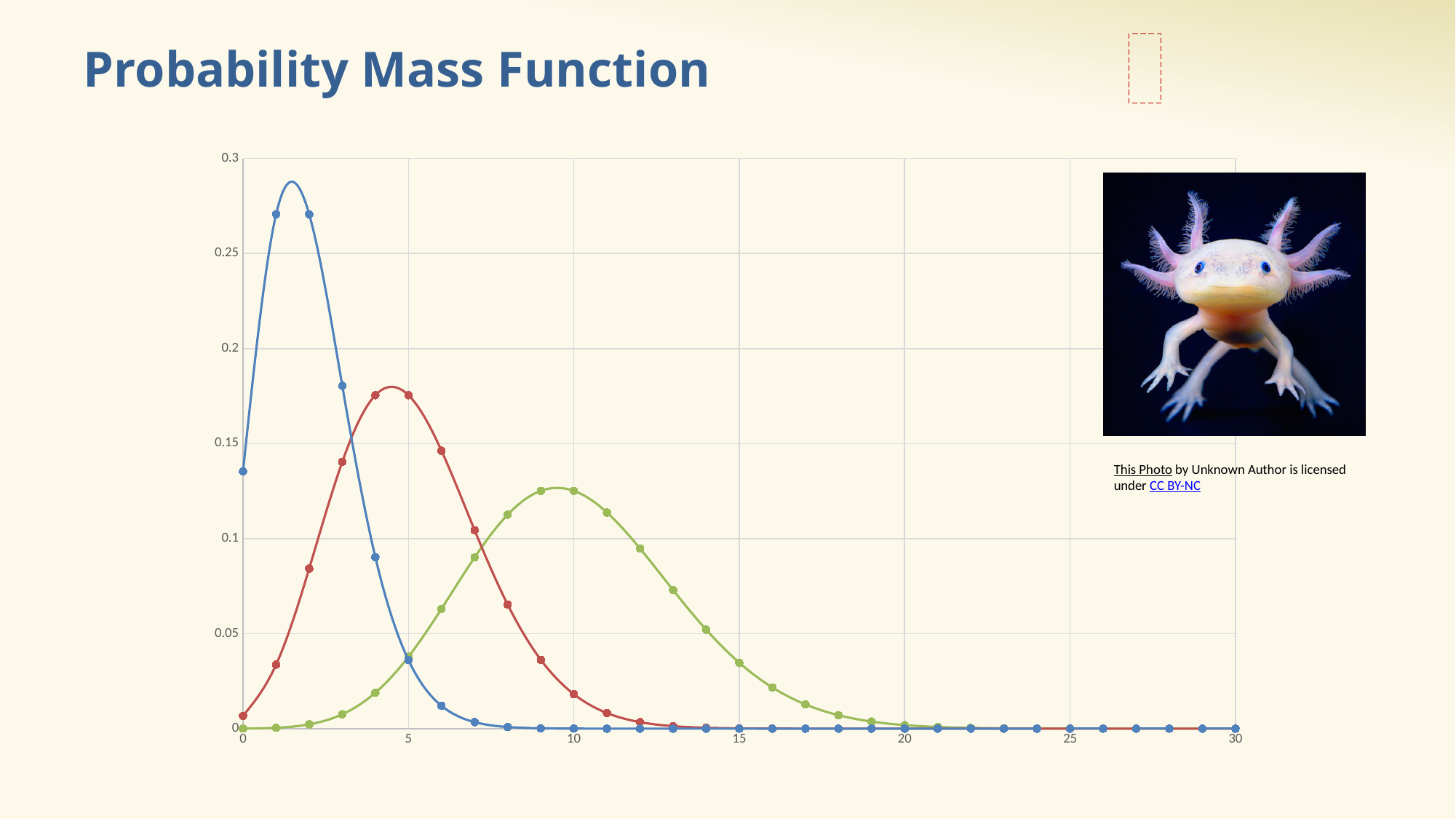
What kind of chart is shown on the slide? line chart Is the value of the blue line at x = 0 greater or less than 0.15? less Do the values of the blue line rise or fall as x increases from 3 to 10? fall Which coloured line reaches the highest peak value? blue At x = 5, which line has the larger value, the red line or the blue line? red How many lines (series) are plotted on the chart? 3 What is the highest value shown on the x axis? 30 Is the peak value of the green line greater or less than 0.15? less Which coloured line has the lowest peak value? green Is the value of the red line at x = 5 greater or less than 0.15? greater